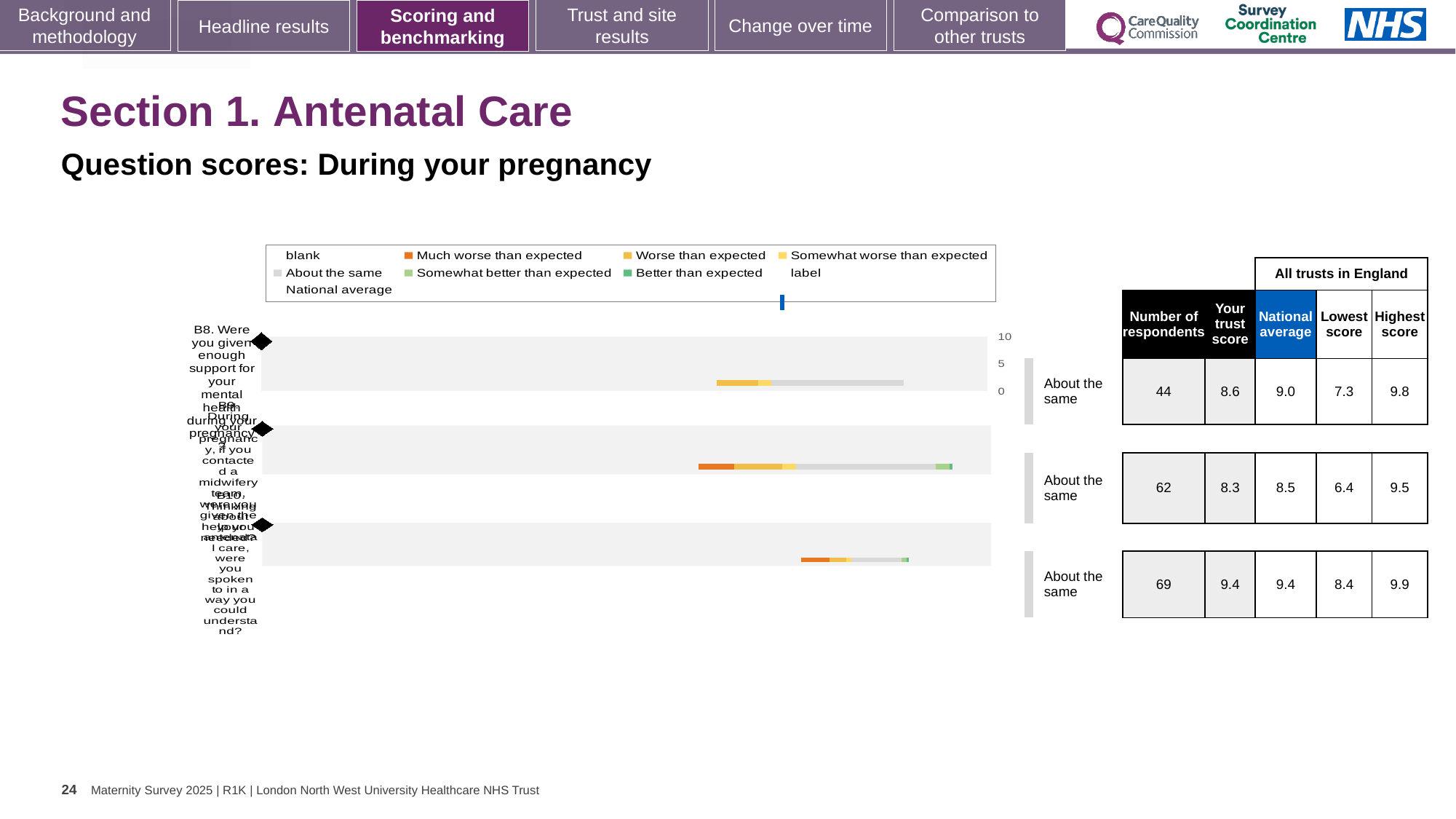
What colour does the legend use for 'Much worse than expected'? orange Which row in the table has the largest number of respondents? the bottom row (69) What benchmark category is shown next to each of the three bars? About the same How many question rows (bars) are plotted in the chart? 3 In the table beside the chart, what is the national average for the bottom row? 9.4 For the top row (B8), which is larger: the trust score or the national average? the national average (9.0) What kind of chart is shown on the slide? bar chart In the table beside the chart, what is the highest score among all trusts in England for the top row (B8)? 9.8 In the table beside the chart, what is the 'Your trust score' for the middle row? 8.3 In the table beside the chart, what is the number of respondents for the top row (B8, support for your mental health during pregnancy)? 44 For the middle row, what is the difference between the national average (8.5) and the trust score (8.3)? 0.2 In the table beside the chart, what is the lowest score among all trusts in England for the middle row? 6.4